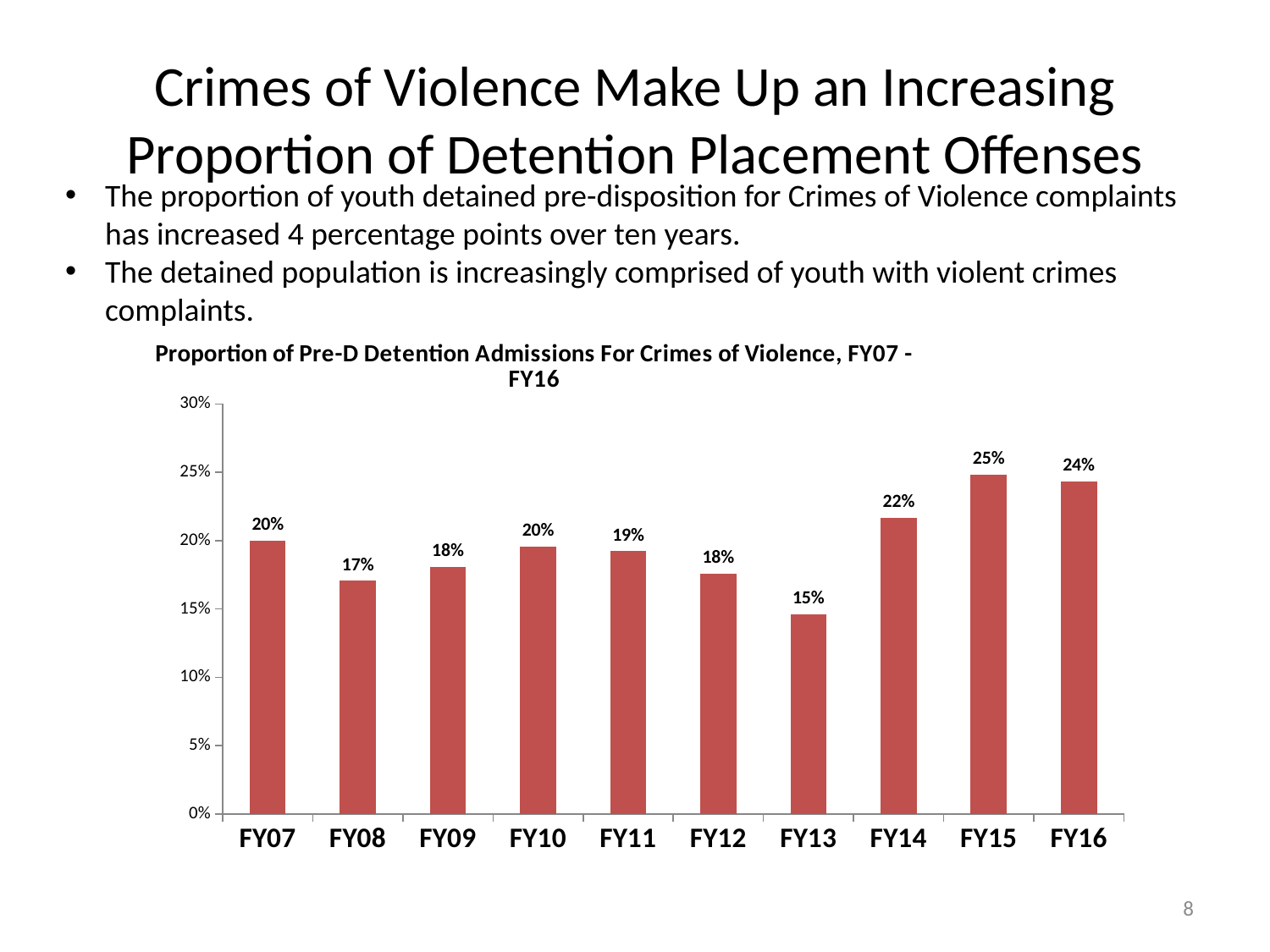
Which fiscal year has the lowest value? FY13 What kind of chart is shown on the slide? Bar chart What is the value for FY13? 15% Which is larger, the value for FY14 or the value for FY12? FY14 What is the difference between the values for FY15 and FY13? 10% How many fiscal years are shown on the x axis? 10 Which fiscal year has the highest value? FY15 What is the difference between the values for FY16 and FY07? 4% What is the value for FY07? 20% What is the value for FY15? 25% Is the value for FY16 greater or less than 20%? greater What is the title of the chart? Proportion of Pre-D Detention Admissions For Crimes of Violence, FY07 - FY16